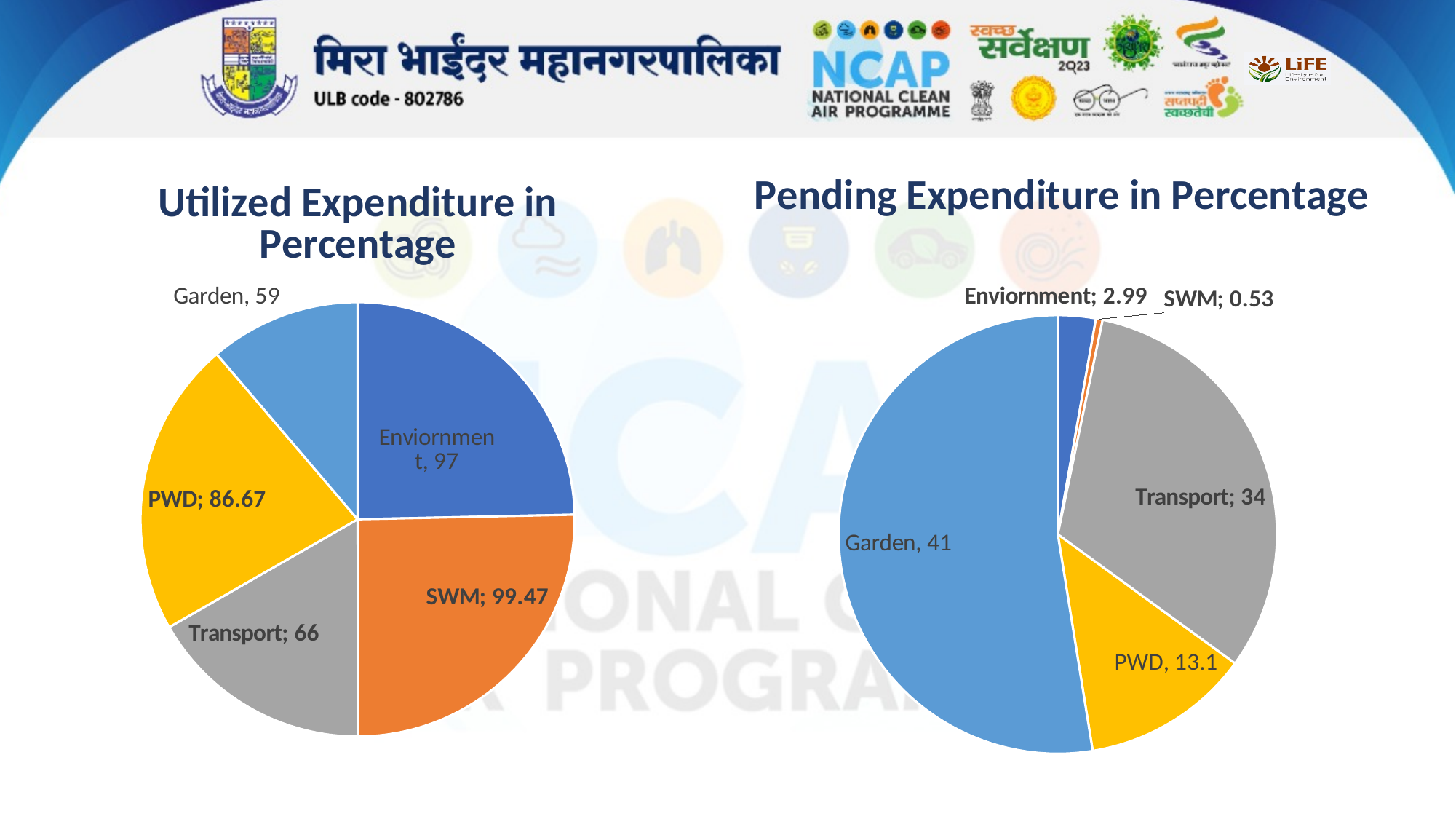
In the Utilized Expenditure in Percentage chart, which category has the highest value? SWM What type of chart is the Utilized Expenditure in Percentage chart? Pie chart In the Pending Expenditure in Percentage chart, which category has the highest value? Garden In the Pending Expenditure in Percentage chart, which category has the lowest value? SWM How many categories are shown in the Pending Expenditure in Percentage chart? 5 In the Pending Expenditure in Percentage chart, what is the value for Transport? 34 In the Utilized Expenditure in Percentage chart, which category has the lowest value? Garden In the Utilized Expenditure in Percentage chart, what is the value for SWM? 99.47 In the Utilized Expenditure in Percentage chart, what is the difference between the Enviornment value and the Transport value? 31 In the Pending Expenditure in Percentage chart, which is larger, the value for PWD or the value for Enviornment? PWD In the Utilized Expenditure in Percentage chart, what is the value for PWD? 86.67 In the Pending Expenditure in Percentage chart, what is the value for SWM? 0.53